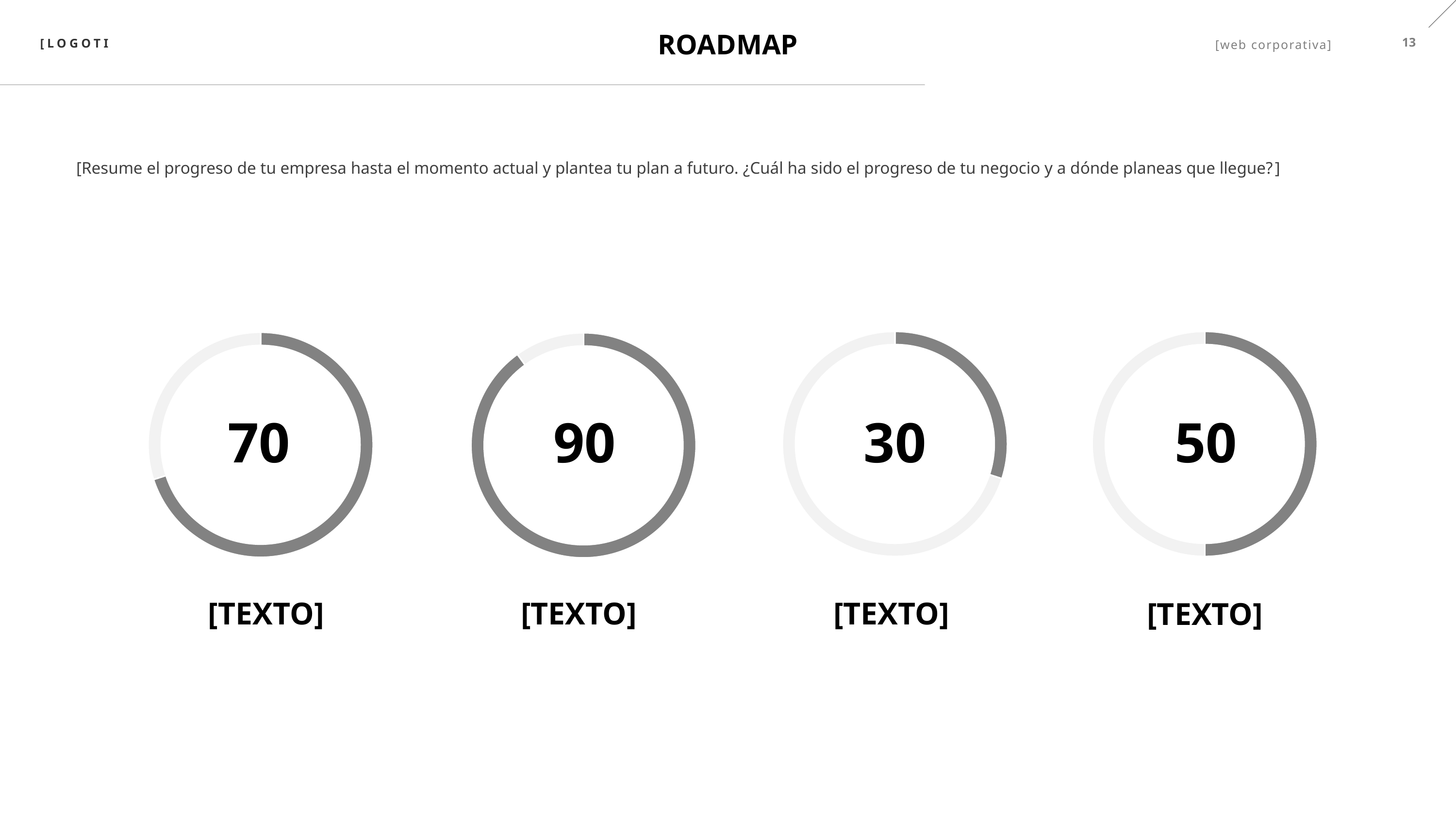
Which of the four ring charts shows the highest value? The second from the left (90) What is the title of the slide containing the four ring charts? ROADMAP How many ring charts are shown on the slide? 4 Which of the four ring charts shows the lowest value? The third from the left (30) What value is shown in the center of the second ring chart from the left? 90 What value is shown in the center of the rightmost ring chart? 50 Which is larger, the value in the leftmost ring chart or the value in the rightmost ring chart? The leftmost (70) What kind of chart is used to display the four values on the slide? Doughnut (ring) chart What is the difference between the value in the leftmost ring chart and the value in the rightmost ring chart? 20 What is the difference between the value in the second ring chart (90) and the value in the third ring chart (30)? 60 What value is shown in the center of the leftmost ring chart? 70 What value is shown in the center of the third ring chart from the left? 30